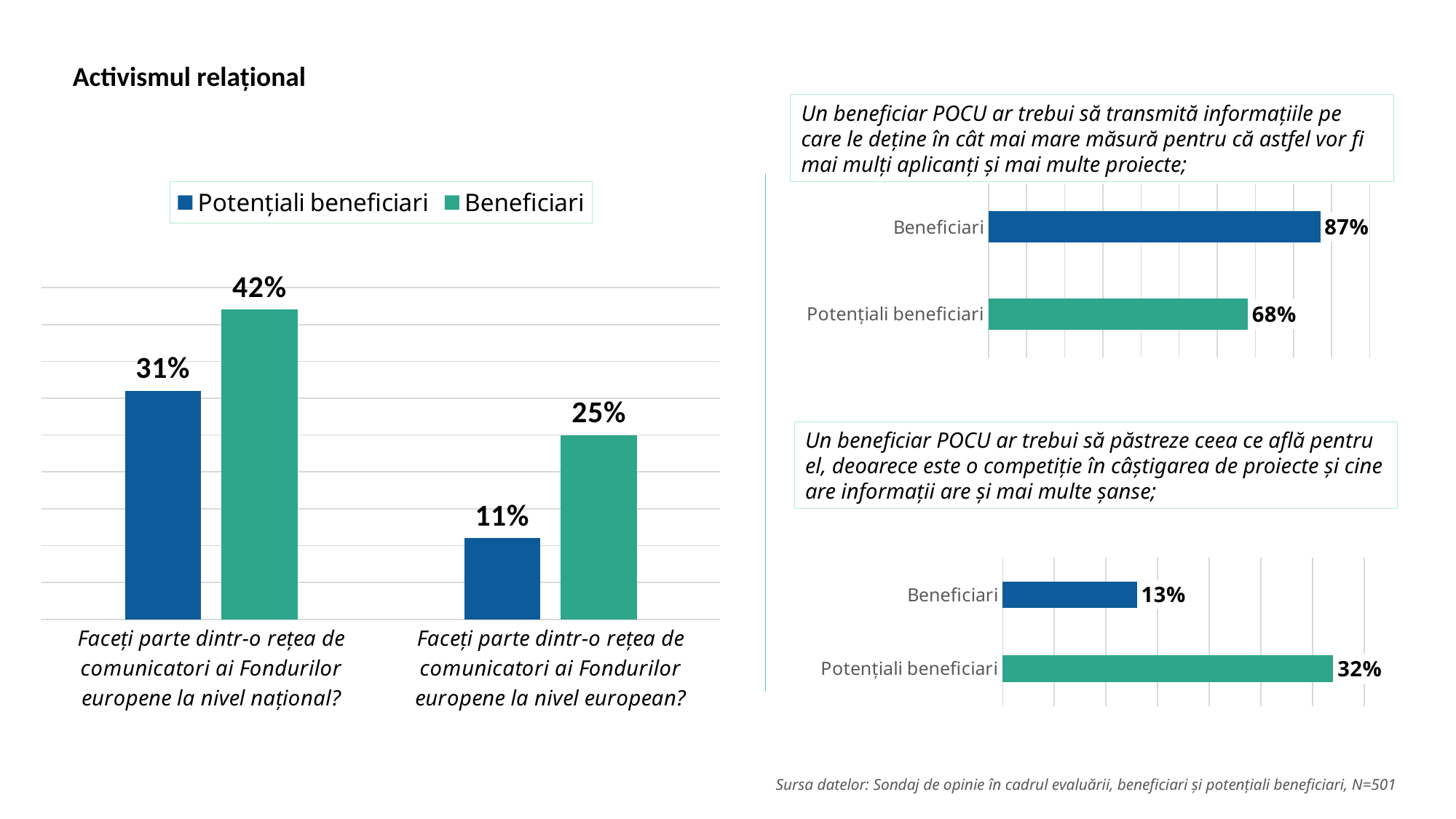
What kind of chart is the left chart? Bar chart In the bottom-right chart, which category has the highest value? Potențiali beneficiari In the top-right chart, what is the difference between Beneficiari and Potențiali beneficiari? 19% In the left chart, what is the value for Beneficiari for the question about a network of communicators at national level? 42% How many series does the legend of the left chart list? 2 How many categories are shown in the bottom-right chart? 2 In the left chart, what is the value for Potențiali beneficiari for the question about a network of communicators at European level? 11% In the top-right chart, what is the value for Beneficiari? 87% In the left chart, what is the difference between Beneficiari and Potențiali beneficiari for the national-level network question? 11% What is the title of the slide above the left chart? Activismul relațional In the bottom-right chart, what is the value for Beneficiari? 13% In the left chart, which series has the higher value for the European-level network question? Beneficiari